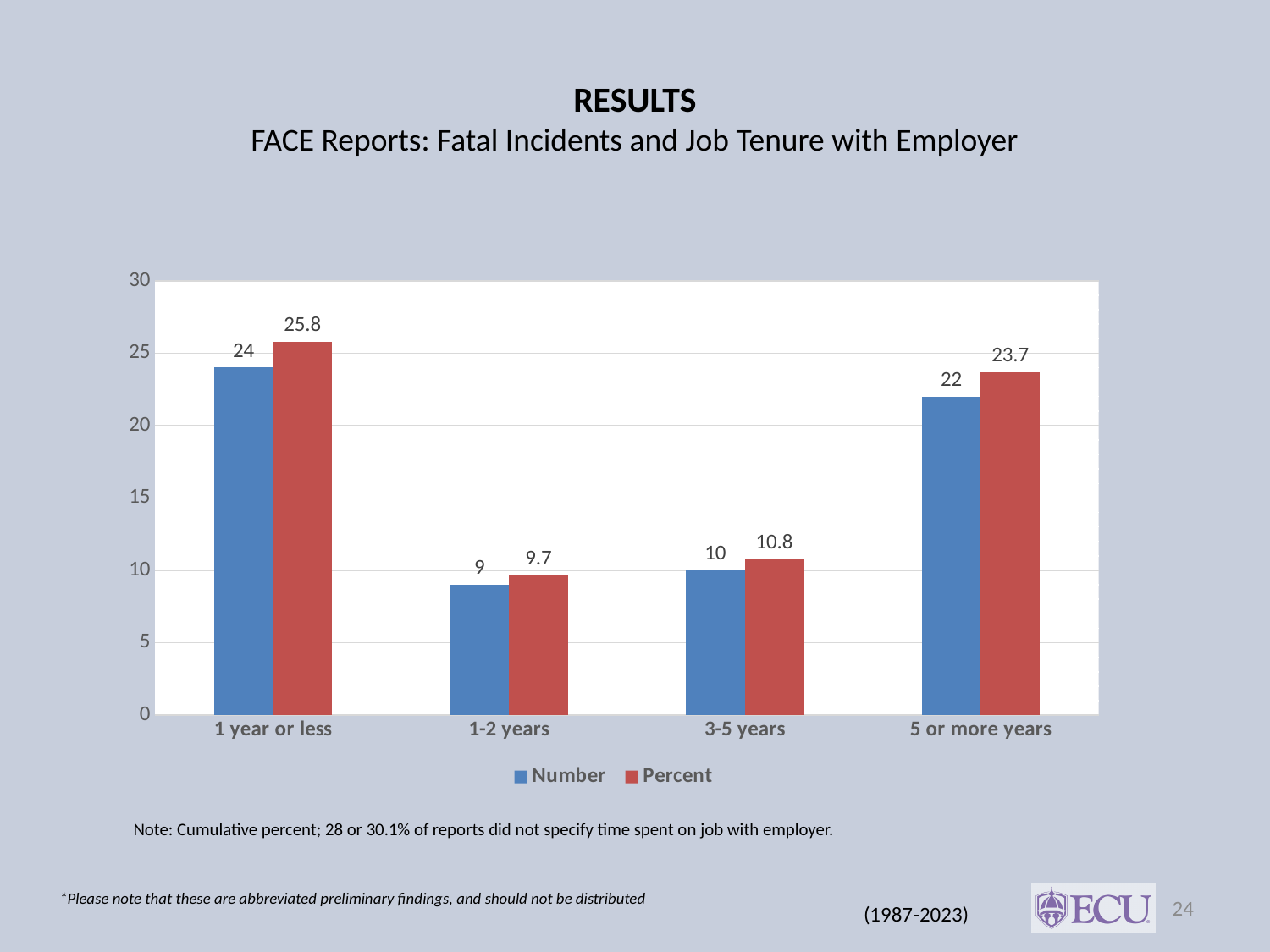
What is the difference between the Number values for '1 year or less' and '5 or more years'? 2 Which category has the lowest Percent value? 1-2 years Is the Percent value for '5 or more years' greater or less than 20? greater How many categories are shown on the x axis? 4 Which is larger: the Number value for '1-2 years' or the Number value for '3-5 years'? 3-5 years How many series does the legend list? 2 What kind of chart is shown on the slide? bar chart Which category has the highest Number value? 1 year or less What are the two series named in the legend? Number and Percent What is the Number value for the '1 year or less' category? 24 What is the Percent value for the '5 or more years' category? 23.7 What is the Percent value for the '3-5 years' category? 10.8